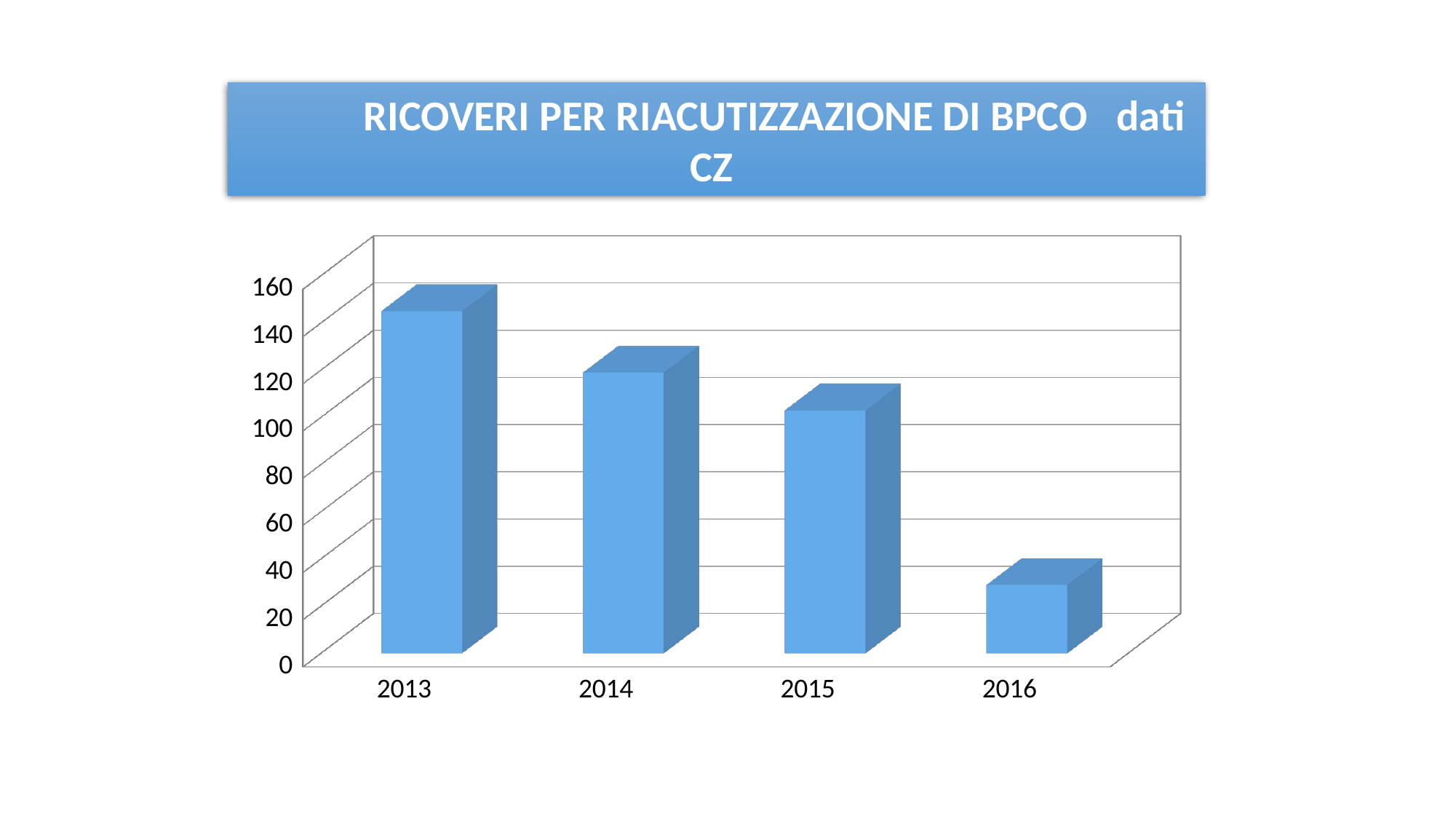
Is the value for 2016 greater or less than 40? less What is the title of the chart? RICOVERI PER RIACUTIZZAZIONE DI BPCO dati CZ Which is larger, the value for 2014 or the value for 2015? 2014 Which is larger, the value for 2016 or the value for 2013? 2013 What type of chart is shown on the slide? bar chart Do the values rise or fall from 2013 to 2016? fall How many years are shown on the x axis of the chart? 4 Is the value for 2014 greater or less than 100? greater Is the value for 2013 greater or less than 140? greater Which year has the highest number of ricoveri? 2013 Which year has the lowest number of ricoveri? 2016